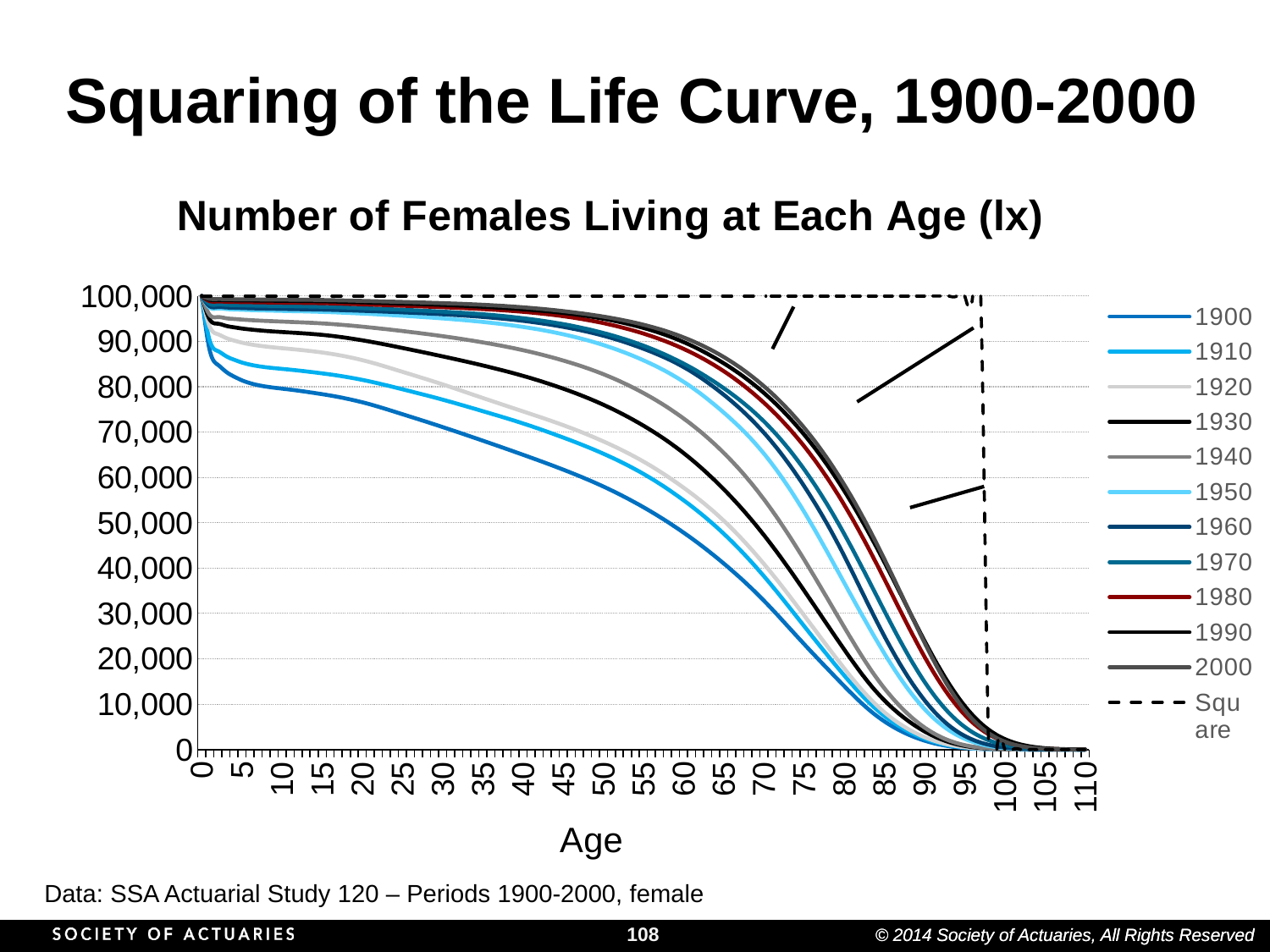
Is the value for the 1900 series at age 40 greater or less than 70,000? less What kind of chart is shown on the slide? line chart How many series does the legend list? 12 Is the value for the Square series at age 50 greater or less than 90,000? greater What is the title of the chart? Number of Females Living at Each Age (lx) What is the label of the x axis? Age Do the values of the 1900 series rise or fall as age increases? fall Which series has the lowest value at age 50? 1900 Is the value for the 1900 series at age 5 greater or less than 90,000? less At age 20, which series has the larger value, 1900 or 1920? 1920 At age 60, which series has the larger value, 1900 or 2000? 2000